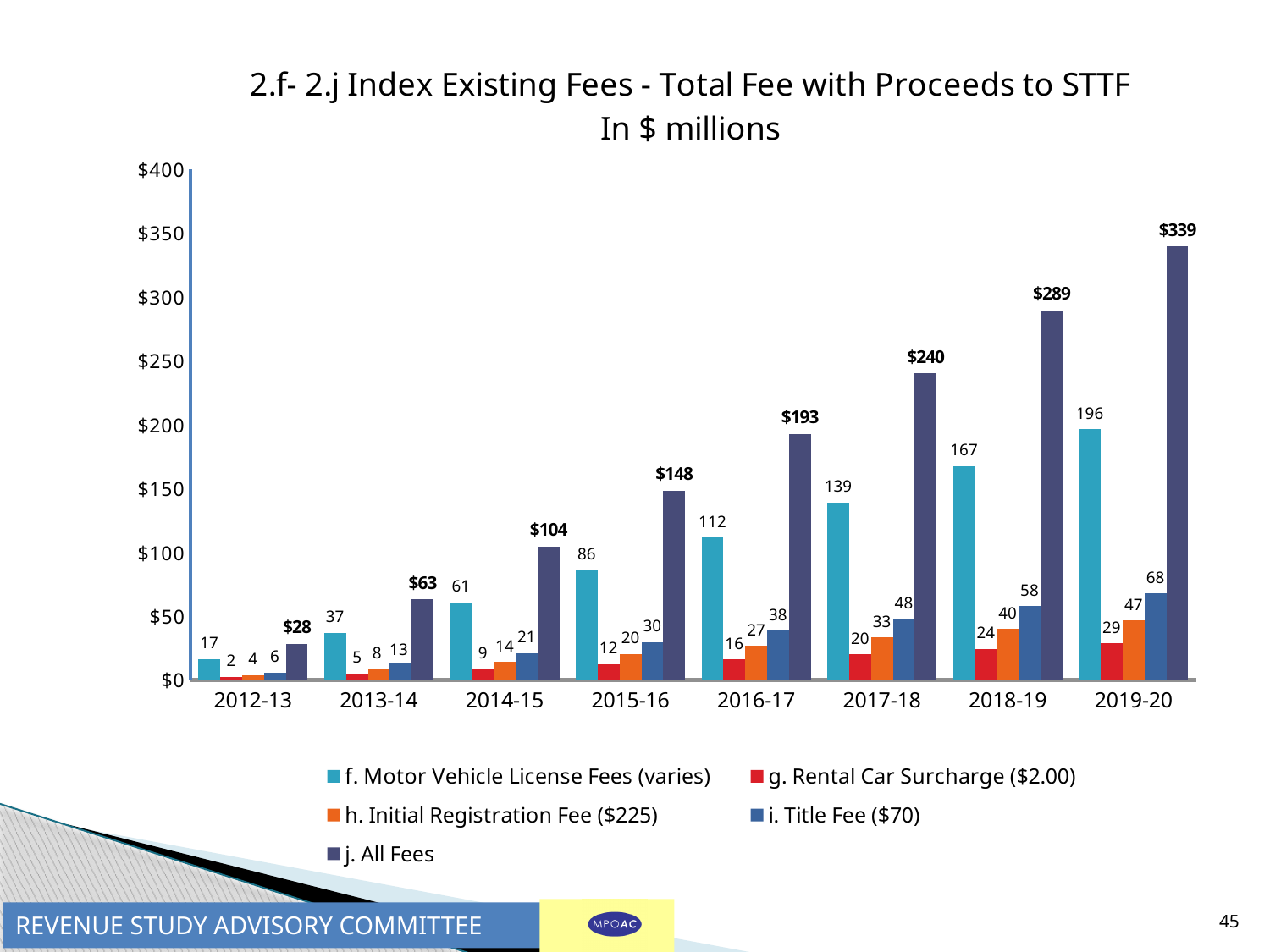
What kind of chart is shown on the slide? Bar chart In which year is j. All Fees lowest? 2012-13 What is the difference between j. All Fees in 2019-20 and in 2018-19? $50 What is the value for h. Initial Registration Fee ($225) in 2014-15? 14 Which is larger in 2015-16: h. Initial Registration Fee ($225) or i. Title Fee ($70)? i. Title Fee ($70) How many series does the legend list? 5 Do the values for j. All Fees rise or fall from 2012-13 to 2019-20? Rise What is the value for j. All Fees in 2019-20? $339 How many fiscal years are shown on the x axis? 8 What is the value for f. Motor Vehicle License Fees (varies) in 2016-17? 112 In which year is f. Motor Vehicle License Fees (varies) highest? 2019-20 What is the value for i. Title Fee ($70) in 2017-18? 48